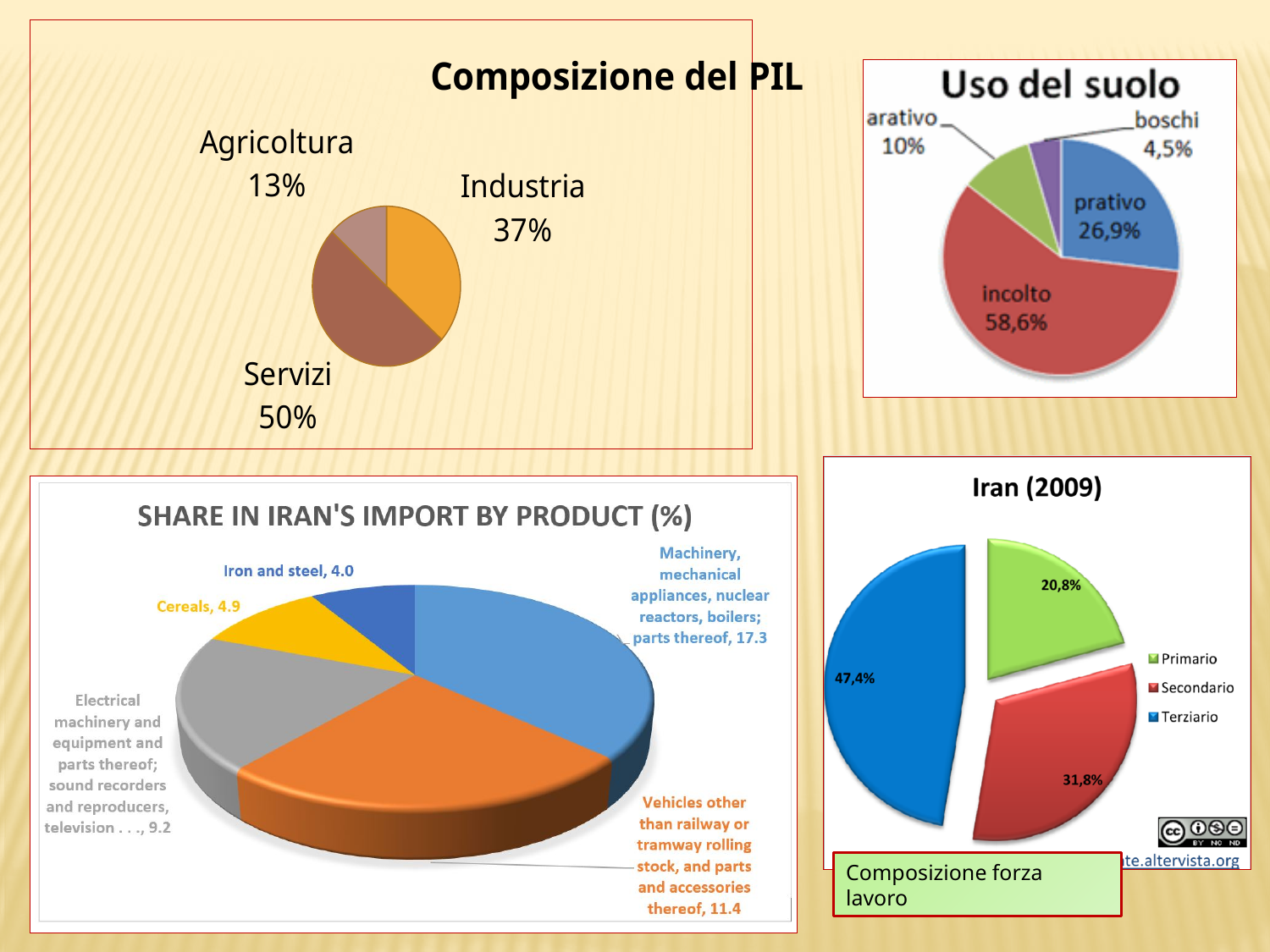
In the 'Uso del suolo' chart, how many categories are shown? 4 In the 'Composizione del PIL' chart, which category has the smallest share? Agricoltura In the 'Iran (2009)' chart, how many entries does the legend list? 3 In the 'Share in Iran's import by product (%)' chart, which product has the largest share? Machinery, mechanical appliances, nuclear reactors, boilers; parts thereof In the 'Uso del suolo' chart, which category has the smallest share? boschi In the 'Uso del suolo' chart, which is larger, prativo or arativo? prativo In the 'Composizione del PIL' chart, what is the value for Servizi? 50% In the 'Composizione del PIL' chart, what is the difference between Industria and Agricoltura? 24% In the 'Share in Iran's import by product (%)' chart, what is the value for Cereals? 4.9 What type of chart is the 'Iran (2009)' chart? Pie chart In the 'Iran (2009)' chart, what is the value for Secondario? 31,8% In the 'Uso del suolo' chart, what is the value for incolto? 58,6%